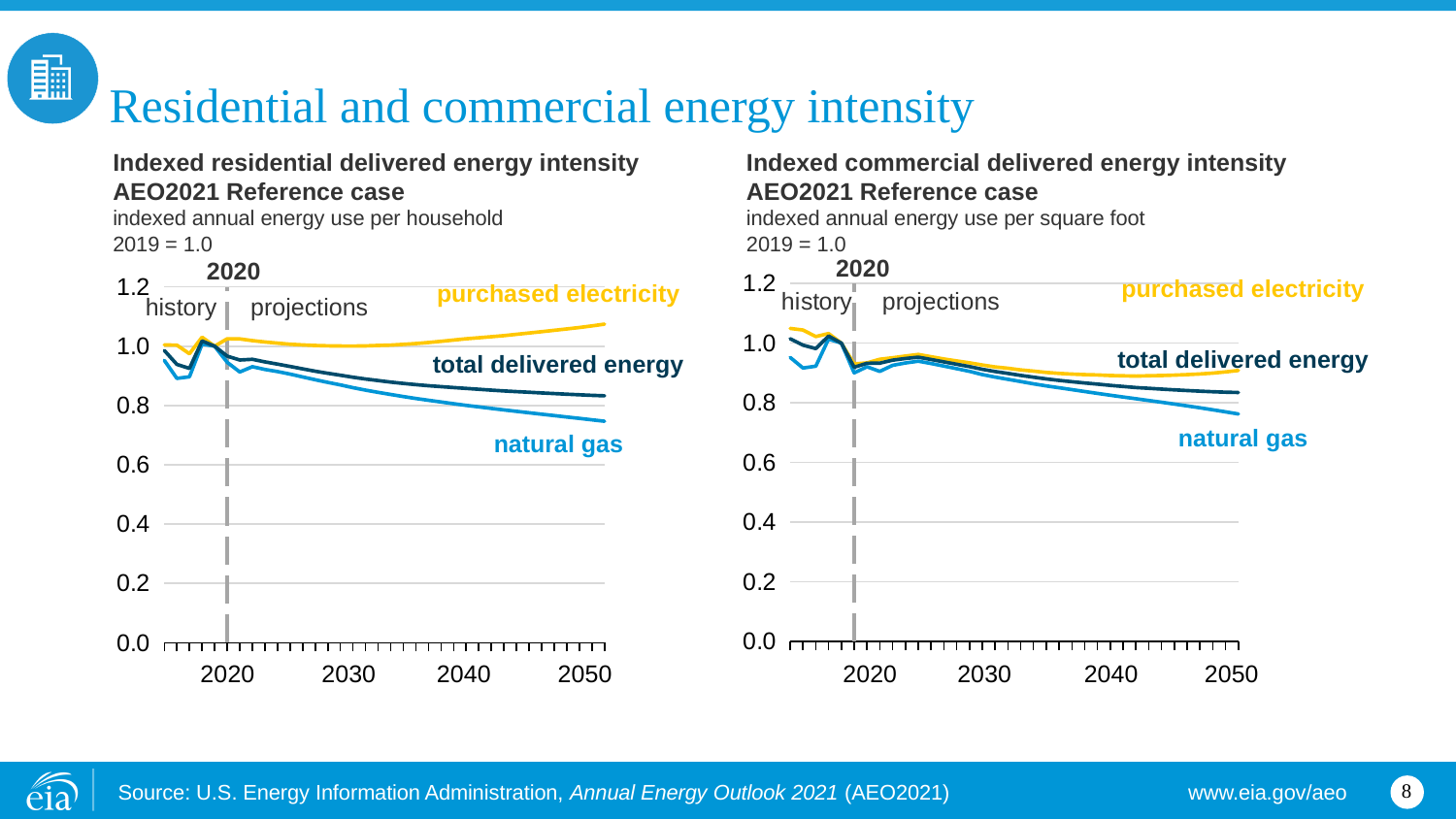
On the 'Indexed residential delivered energy intensity' chart, does the purchased electricity line rise or fall between 2030 and 2050? rise On the 'Indexed commercial delivered energy intensity' chart, does the total delivered energy line rise or fall over the projection period? fall On the 'Indexed residential delivered energy intensity' chart, which series is higher in 2050: purchased electricity or natural gas? purchased electricity On the 'Indexed residential delivered energy intensity' chart, which year does the dashed vertical line separating history from projections mark? 2020 On the 'Indexed residential delivered energy intensity' chart, is the natural gas value in 2050 greater or less than 0.8? less How many series are plotted on the 'Indexed commercial delivered energy intensity' chart? 3 On the 'Indexed commercial delivered energy intensity' chart, is the purchased electricity value in 2050 greater or less than 1.0? less On the 'Indexed commercial delivered energy intensity' chart, which year is indexed to 1.0? 2019 What kind of chart is the 'Indexed residential delivered energy intensity' chart? line chart On the 'Indexed residential delivered energy intensity' chart, does the natural gas line rise or fall over the projection period? fall On the 'Indexed commercial delivered energy intensity' chart, which series is lowest in 2050? natural gas On the 'Indexed residential delivered energy intensity' chart, is the purchased electricity value in 2050 greater or less than 1.0? greater